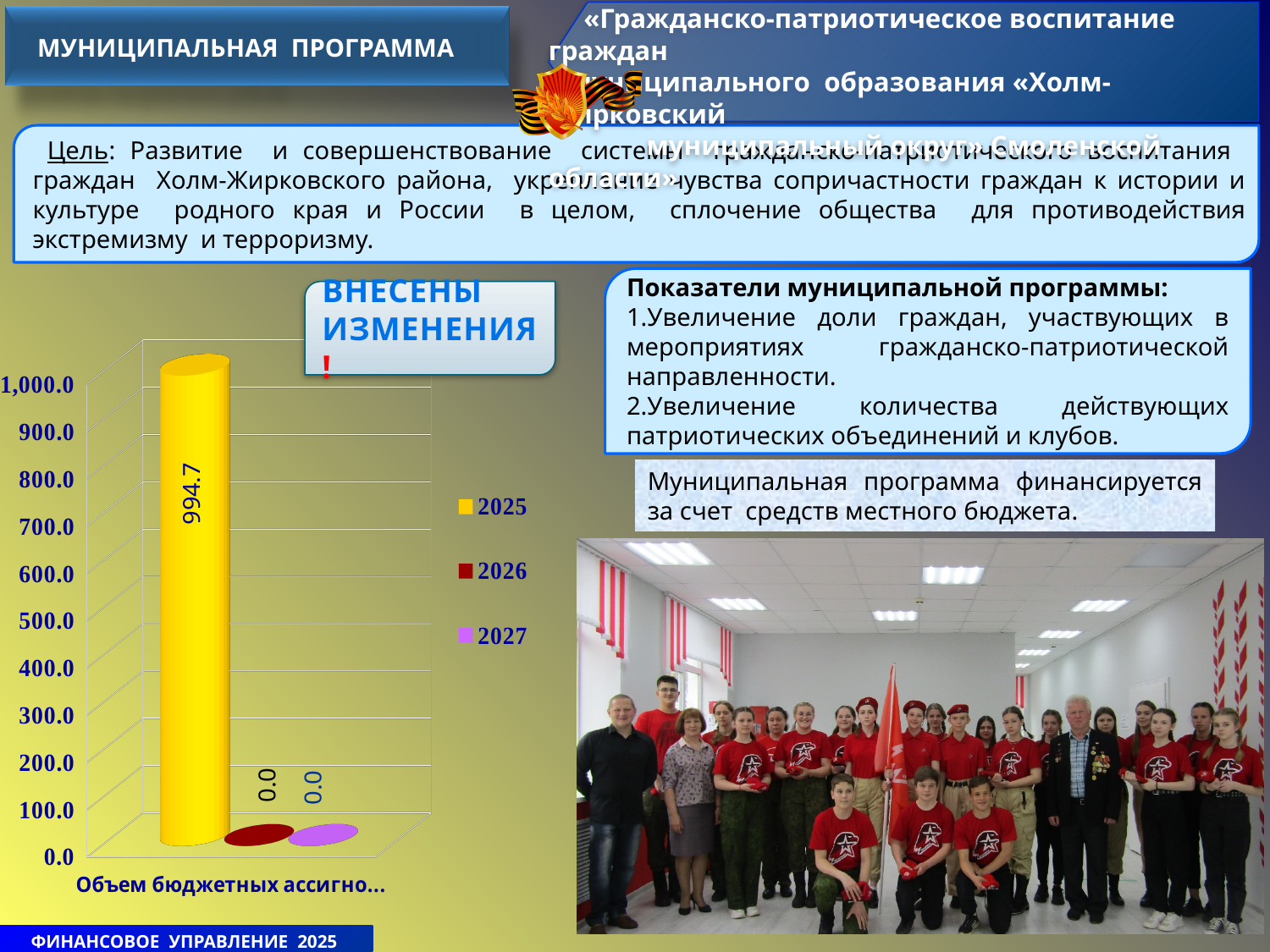
What is the value of the 2026 series in the bar chart? 0.0 What is the value of the 2027 series in the bar chart? 0.0 What is the highest value shown on the vertical axis of the bar chart? 1,000.0 How many series does the legend of the bar chart list? 3 What colour represents the 2025 series in the bar chart legend? yellow Is the value for 2025 in the bar chart greater or less than 900.0? greater What is the difference between the 2025 value and the 2026 value in the bar chart? 994.7 What is the value of the 2025 series in the bar chart? 994.7 Which series has the highest value in the bar chart? 2025 What kind of chart is shown on the slide? bar chart How many series in the bar chart have a value of 0.0? 2 Which is larger in the bar chart, the 2025 value or the 2027 value? 2025